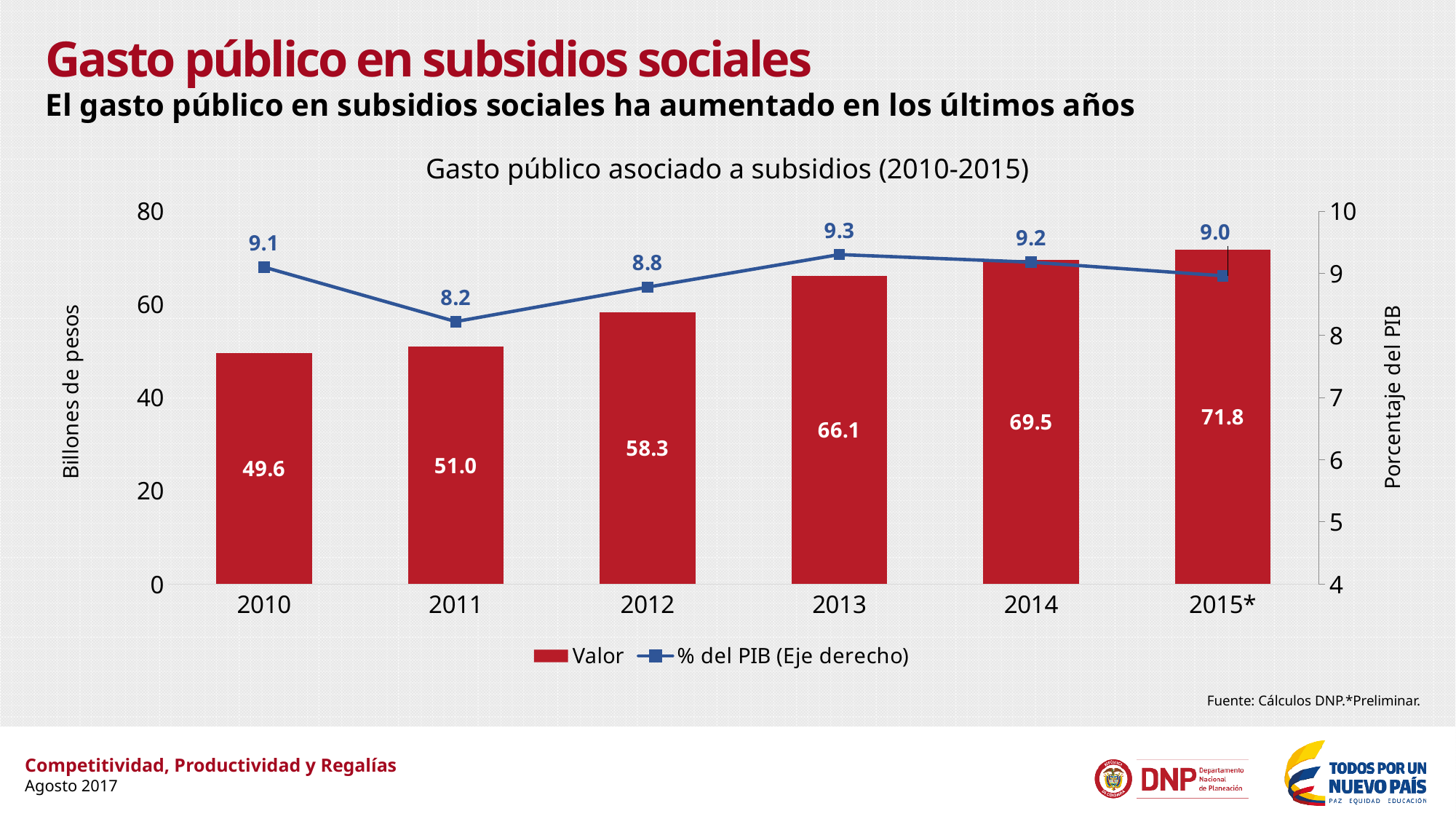
Which is larger, the % del PIB for 2010 or for 2015*? 2010 What is the difference between the Valor for 2014 and the Valor for 2010? 19.9 What is the Valor for 2015*? 71.8 Which year has the lowest % del PIB? 2011 What is the % del PIB value for 2013? 9.3 Does the Valor series rise or fall from 2010 to 2015*? rise How many years are shown on the x axis? 6 Is the Valor for 2013 greater or less than 60? greater How many series does the legend list? 2 What is the value of the Valor series for 2012? 58.3 What is the title of the chart? Gasto público asociado a subsidios (2010-2015) Which year has the highest Valor? 2015*